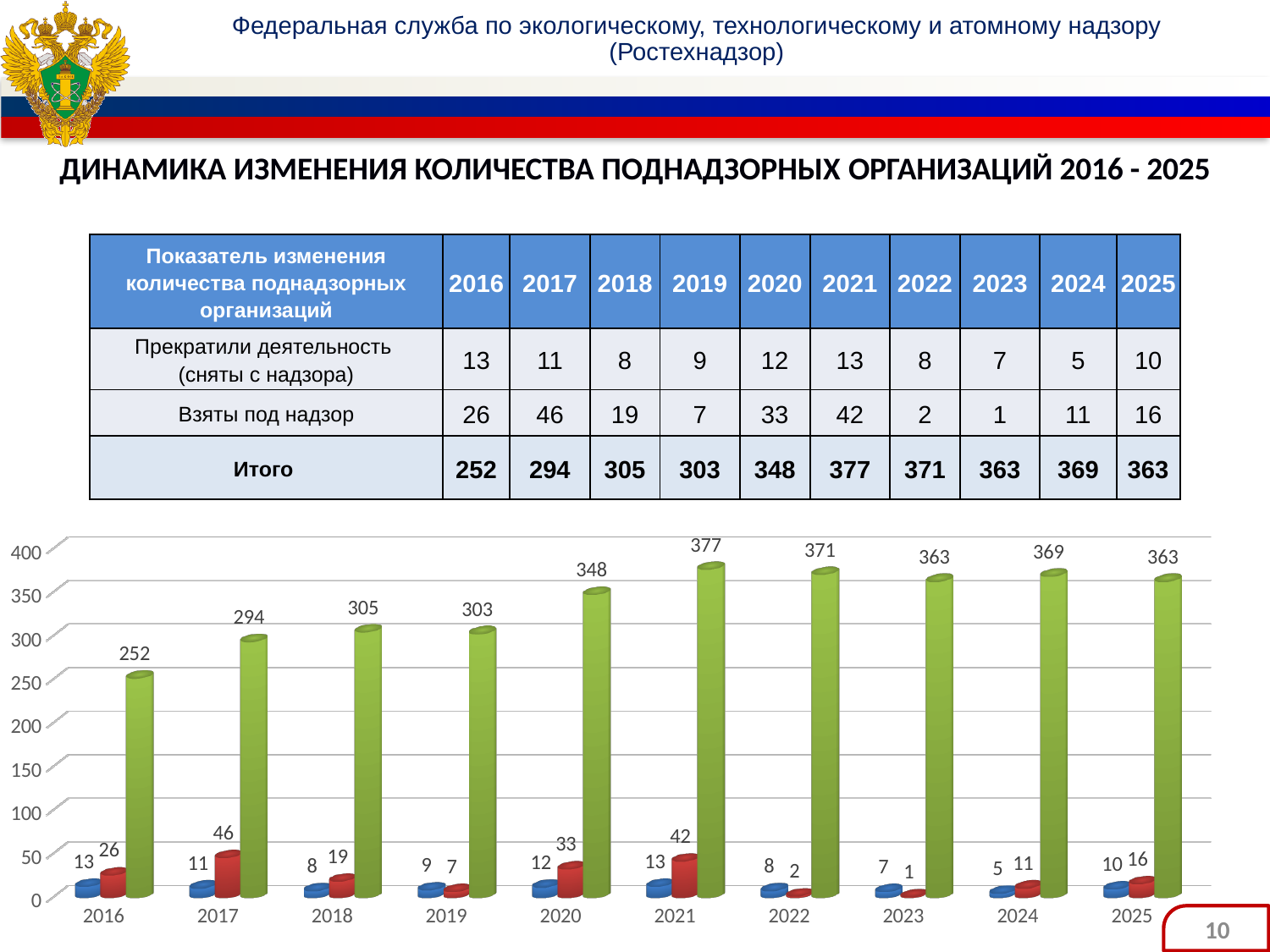
What is the difference between the green bar values for 2021 and 2016? 125 Is the green bar for 2018 greater or less than 300? greater How many years (categories) are shown on the x axis of the chart? 10 What kind of chart is shown on the slide? bar chart In which year is the green bar (Итого) lowest? 2016 Which is larger, the green bar for 2020 or the green bar for 2019? 2020 What is the value of the green bar for 2016? 252 In which year is the red bar (Взяты под надзор) lowest? 2023 What is the value of the red bar (Взяты под надзор) for 2017? 46 In which year is the green bar (Итого) highest? 2021 Does the green bar (Итого) rise or fall from 2016 to 2021? rise What is the value of the tallest (green) bar for 2021? 377